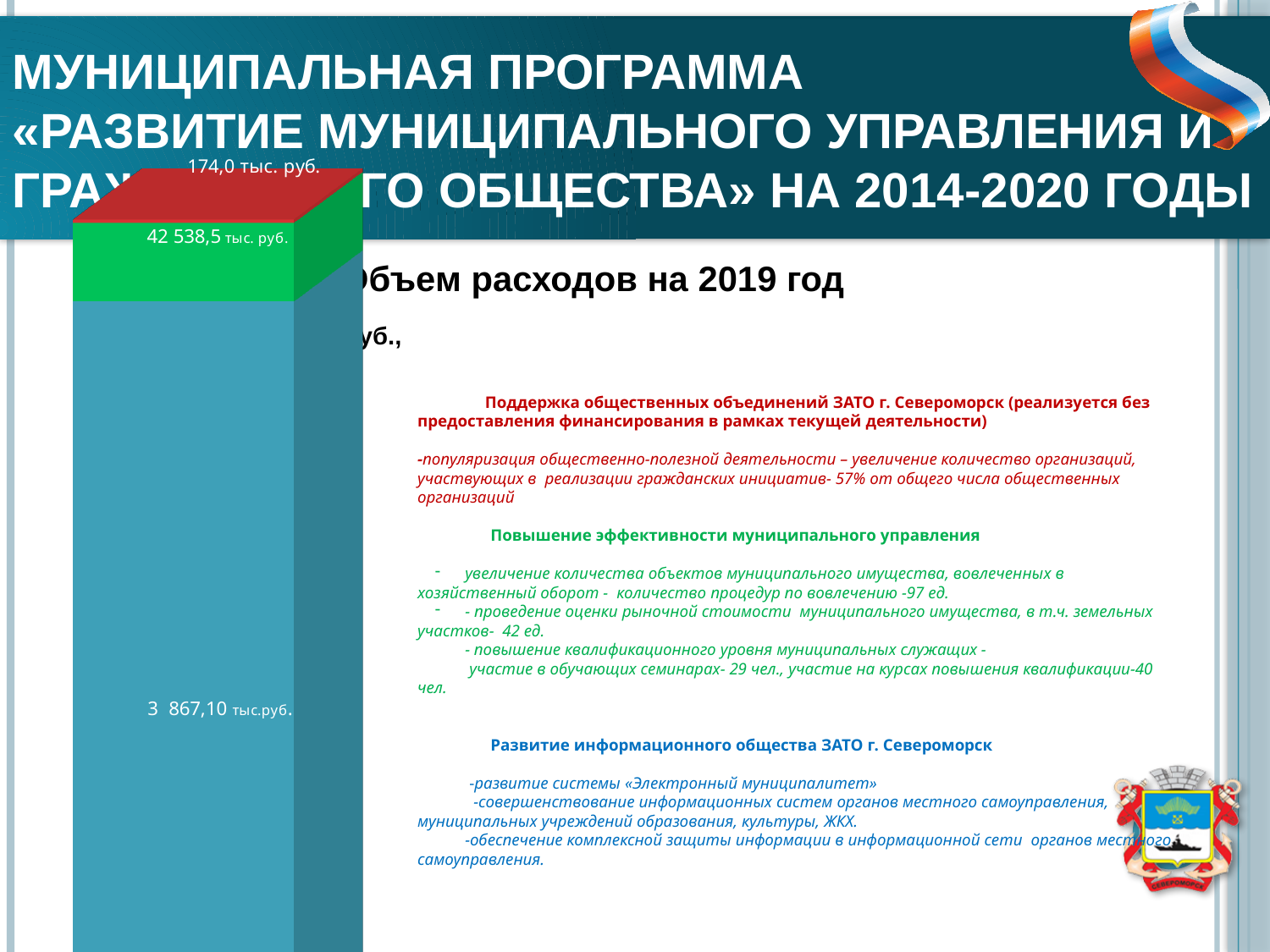
What value is printed on the green (middle) segment of the stacked bar? 42 538,5 тыс. руб. How many segments does the stacked bar contain? 3 What value is printed on the blue (bottom) segment of the stacked bar? 3 867,10 тыс.руб. What is the difference between the blue segment's value and the red segment's value? 3 693,1 тыс. руб. What value is printed on the red (top) segment of the stacked bar? 174,0 тыс. руб. What is the total of the three labelled segments of the stacked bar? 46 579,6 тыс. руб. Which labelled value is larger: the green segment or the blue segment? the green segment What is the difference between the green segment's value and the blue segment's value? 38 671,4 тыс. руб. What colour is the segment labelled 3 867,10 тыс.руб.? blue Which segment of the stacked bar has the smallest labelled value? the red segment (174,0 тыс. руб.) What kind of chart is shown on the left of the slide? a stacked bar chart Which segment of the stacked bar has the largest labelled value? the green segment (42 538,5 тыс. руб.)